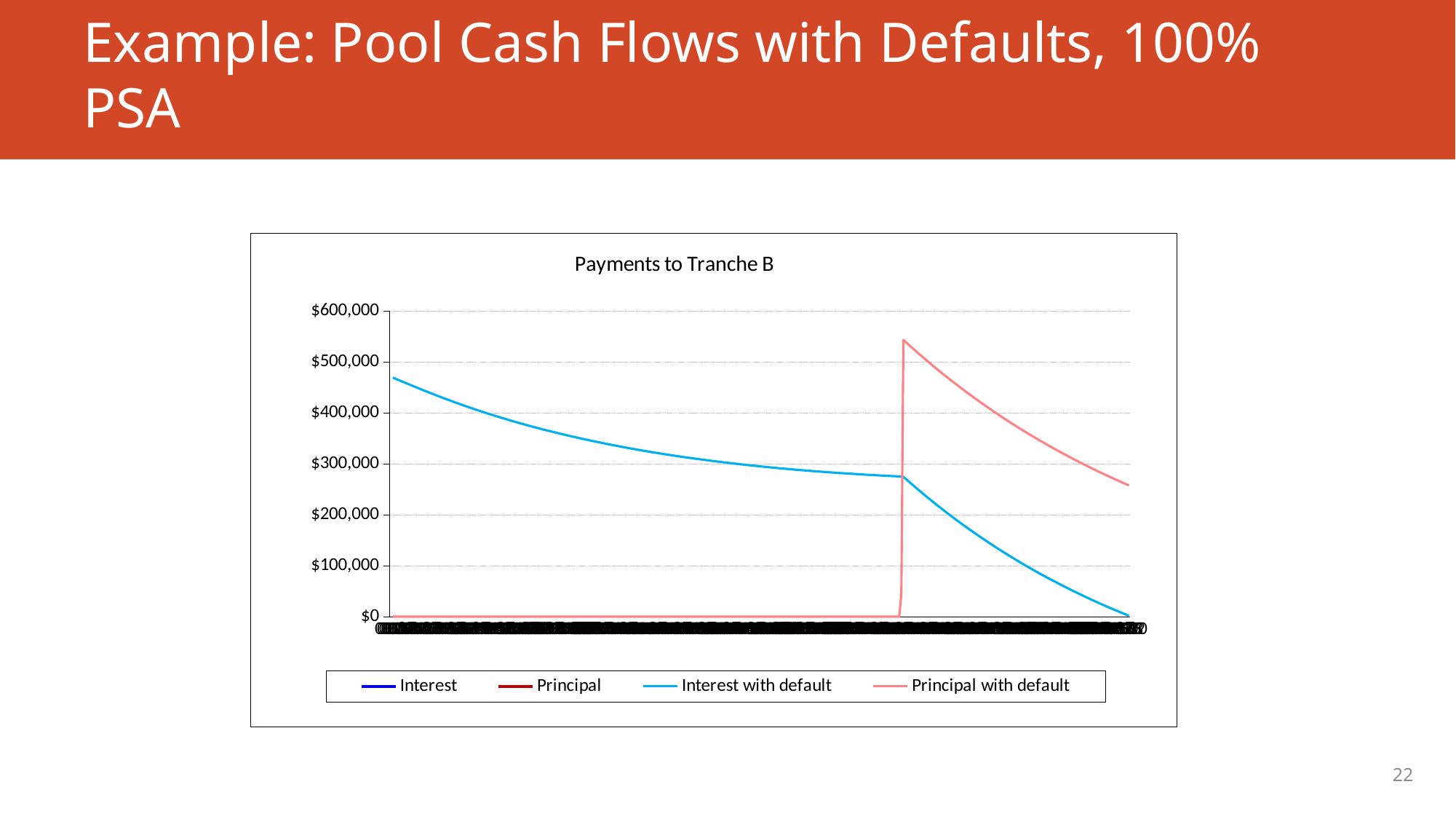
Does the Interest with default series rise or fall along the x axis? Fall Is the peak value of the Principal with default series greater or less than $600,000? less At the right edge of the chart, which is larger: Interest with default or Principal with default? Principal with default Is the starting value of the Interest with default series greater or less than $400,000? greater Is the peak value of the Principal with default series greater or less than $500,000? greater What is the title of the chart? Payments to Tranche B What kind of chart is shown on the slide? Line chart Which series reaches the highest value on the chart? Principal with default At the left edge of the chart, which is larger: Interest with default or Principal with default? Interest with default What is the highest value labelled on the y axis? $600,000 How many series does the legend list? 4